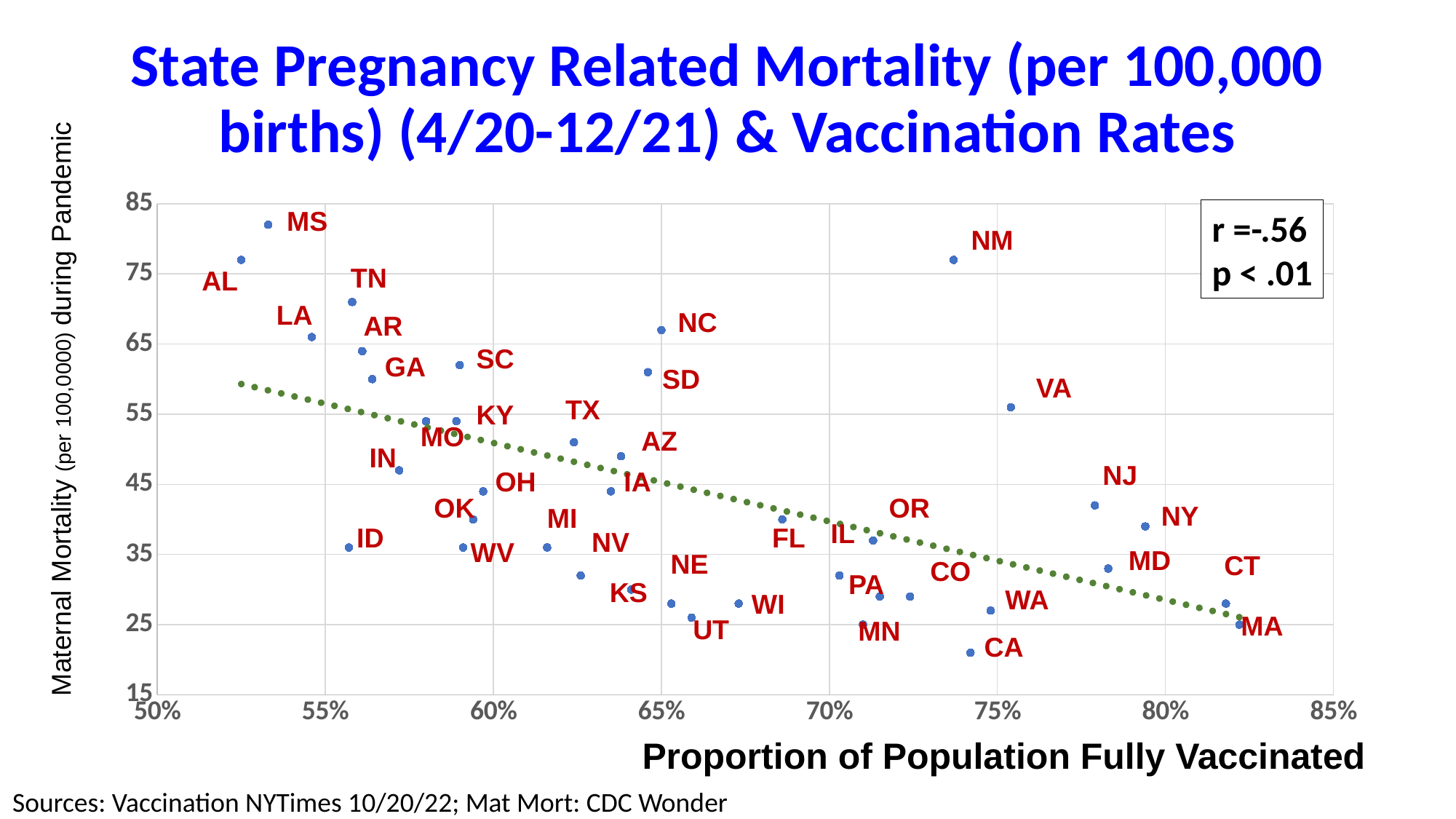
Which state has a higher maternal mortality value, NM or CA? NM Which state has the lowest maternal mortality value on the chart? CA What is the label of the x axis? Proportion of Population Fully Vaccinated Is the maternal mortality value for NJ greater or less than 45? less Is the maternal mortality value for CA greater or less than 25? less Is the maternal mortality value for NC greater or less than 65? greater What correlation coefficient (r) is shown on the chart? -.56 What kind of chart is shown on the slide? scatter plot As the proportion of the population fully vaccinated increases along the x axis, does maternal mortality generally rise or fall according to the trend line? fall Which state has the highest maternal mortality value on the chart? MS